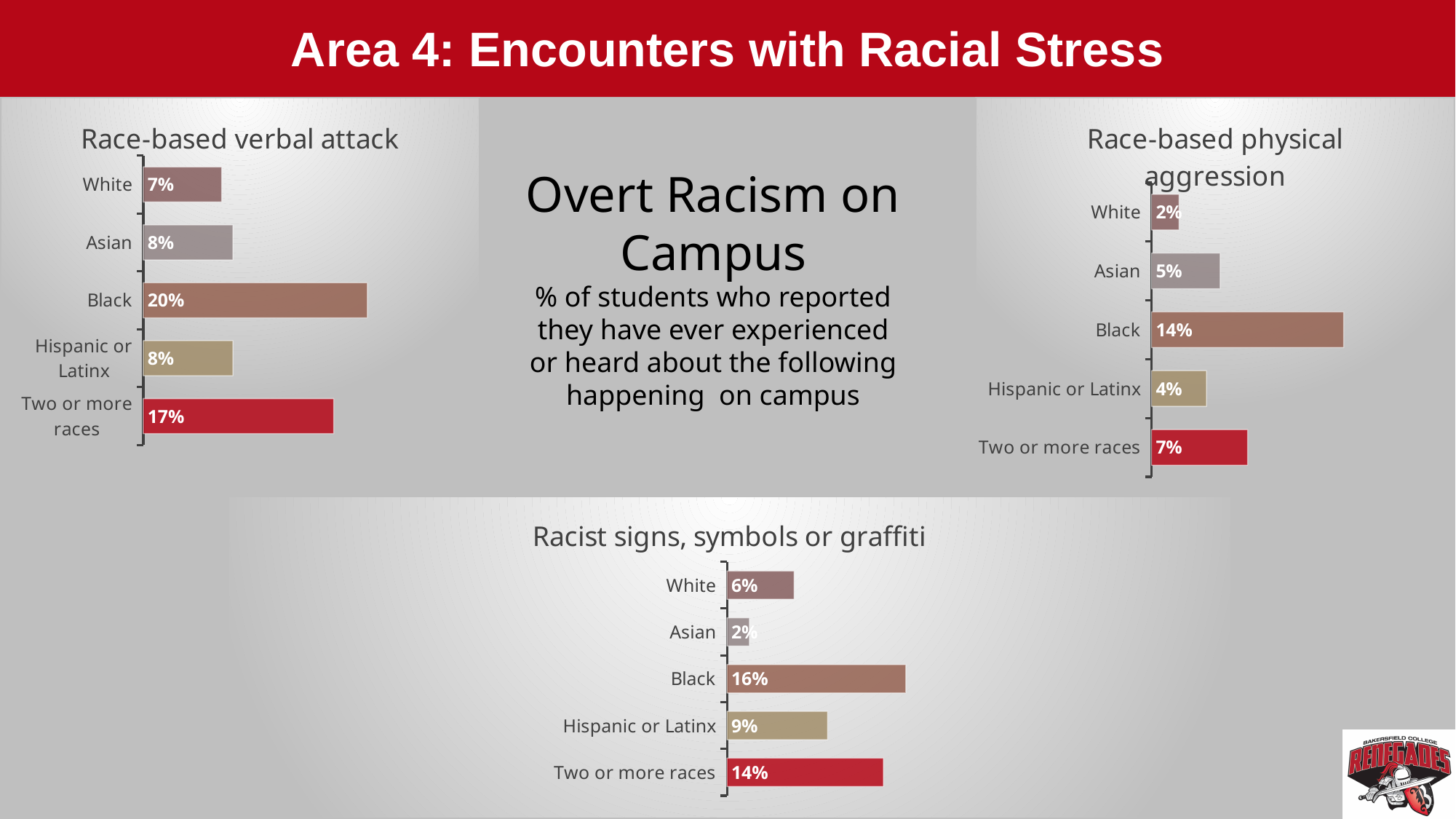
In the 'Race-based physical aggression' chart, which category has the highest value? Black In the 'Racist signs, symbols or graffiti' chart, which category has the lowest value? Asian In the 'Race-based physical aggression' chart, what is the value for Hispanic or Latinx students? 4% How many categories are shown in the 'Racist signs, symbols or graffiti' chart? 5 How many charts are shown on the slide? 3 In the 'Racist signs, symbols or graffiti' chart, what is the value for Asian students? 2% What type of chart is the 'Race-based verbal attack' chart? Bar chart In the 'Race-based verbal attack' chart, which category has the lowest value? White In the 'Race-based verbal attack' chart, what is the difference between the values for Black and Two or more races? 3% In the 'Race-based physical aggression' chart, which is larger, the value for Asian or the value for Two or more races? Two or more races In the 'Race-based verbal attack' chart, what is the value for Black students? 20% In the 'Racist signs, symbols or graffiti' chart, what is the difference between the values for Black and Hispanic or Latinx? 7%